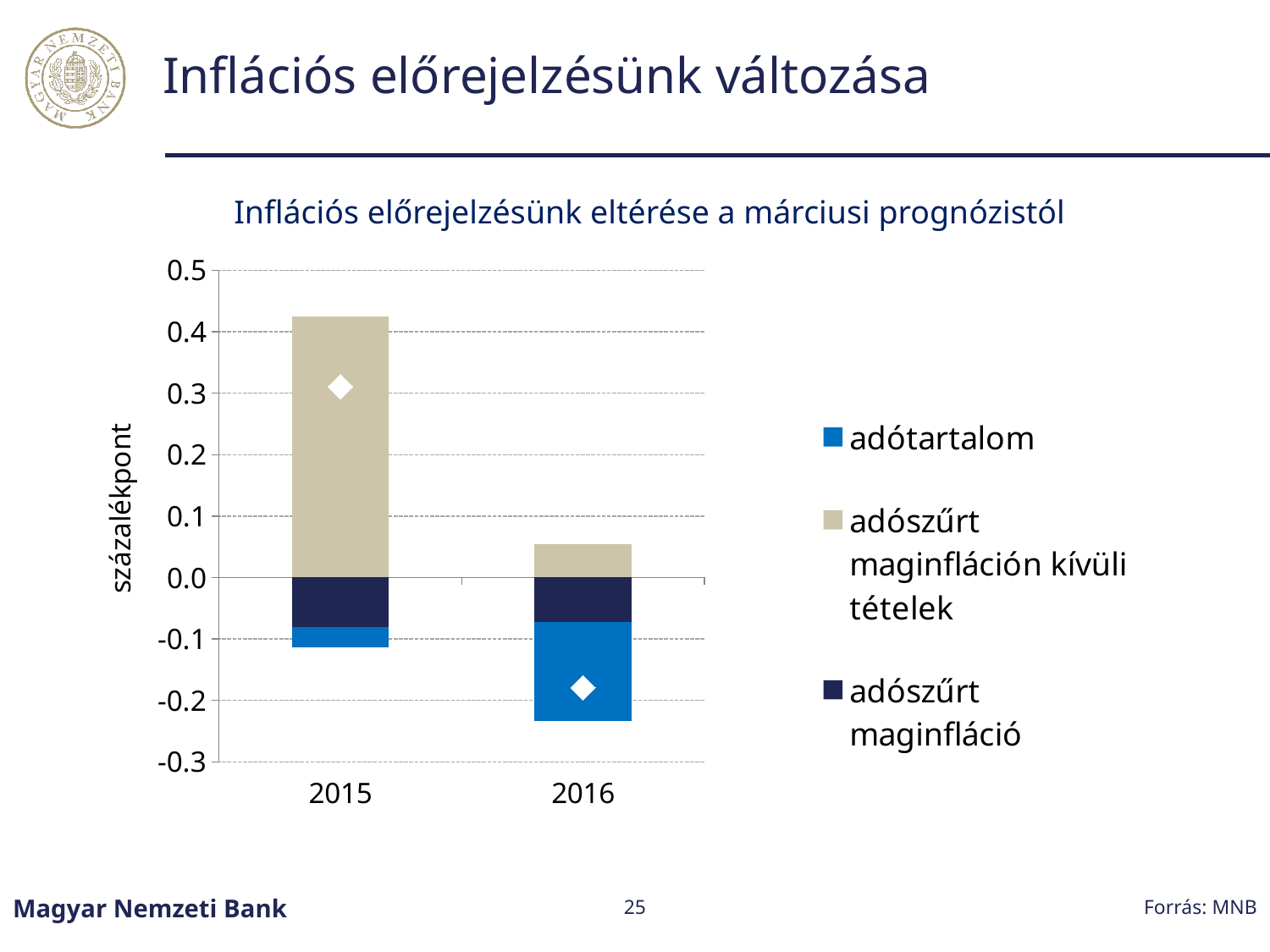
Is the diamond marker for 2015 greater or less than 0.2? greater What is the label on the vertical axis of the chart? százalékpont Is the top of the 'adószűrt maginfláción kívüli tételek' segment for 2015 greater or less than 0.3? greater How many years (categories) are shown on the x axis of the chart? 2 In which year is the diamond marker highest? 2015 What kind of chart is shown on the slide? Stacked bar chart Which year has the larger 'adószűrt maginfláción kívüli tételek' segment, 2015 or 2016? 2015 Which year has the larger (more negative) 'adótartalom' segment, 2015 or 2016? 2016 Is the bottom of the 'adótartalom' segment for 2016 greater or less than -0.2? less How many series does the chart's legend list? 3 What is the title of the chart? Inflációs előrejelzésünk eltérése a márciusi prognózistól